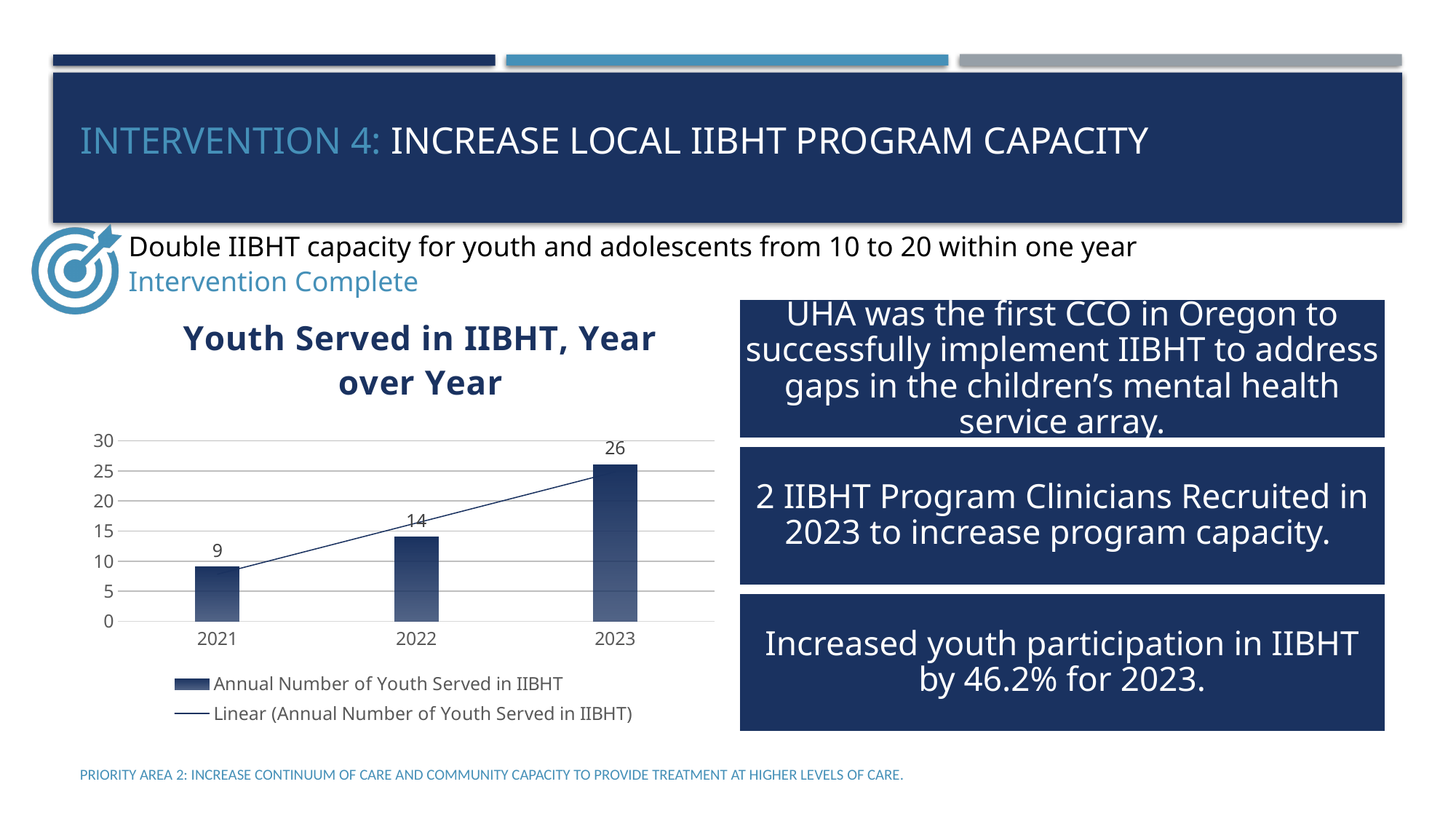
Is the value for 2023 greater or less than 25? greater Which year has the highest number of youth served in IIBHT? 2023 What is the difference between the number of youth served in 2023 and in 2022? 12 Do the values rise or fall from 2021 to 2023? Rise Which year has the lowest number of youth served in IIBHT? 2021 What is the difference between the number of youth served in 2022 and in 2021? 5 How many years are shown on the x axis of the chart? 3 What is the annual number of youth served in IIBHT in 2022? 14 What kind of chart is used to show youth served in IIBHT? Bar chart What is the annual number of youth served in IIBHT in 2023? 26 What is the annual number of youth served in IIBHT in 2021? 9 Which year had more youth served in IIBHT, 2021 or 2022? 2022